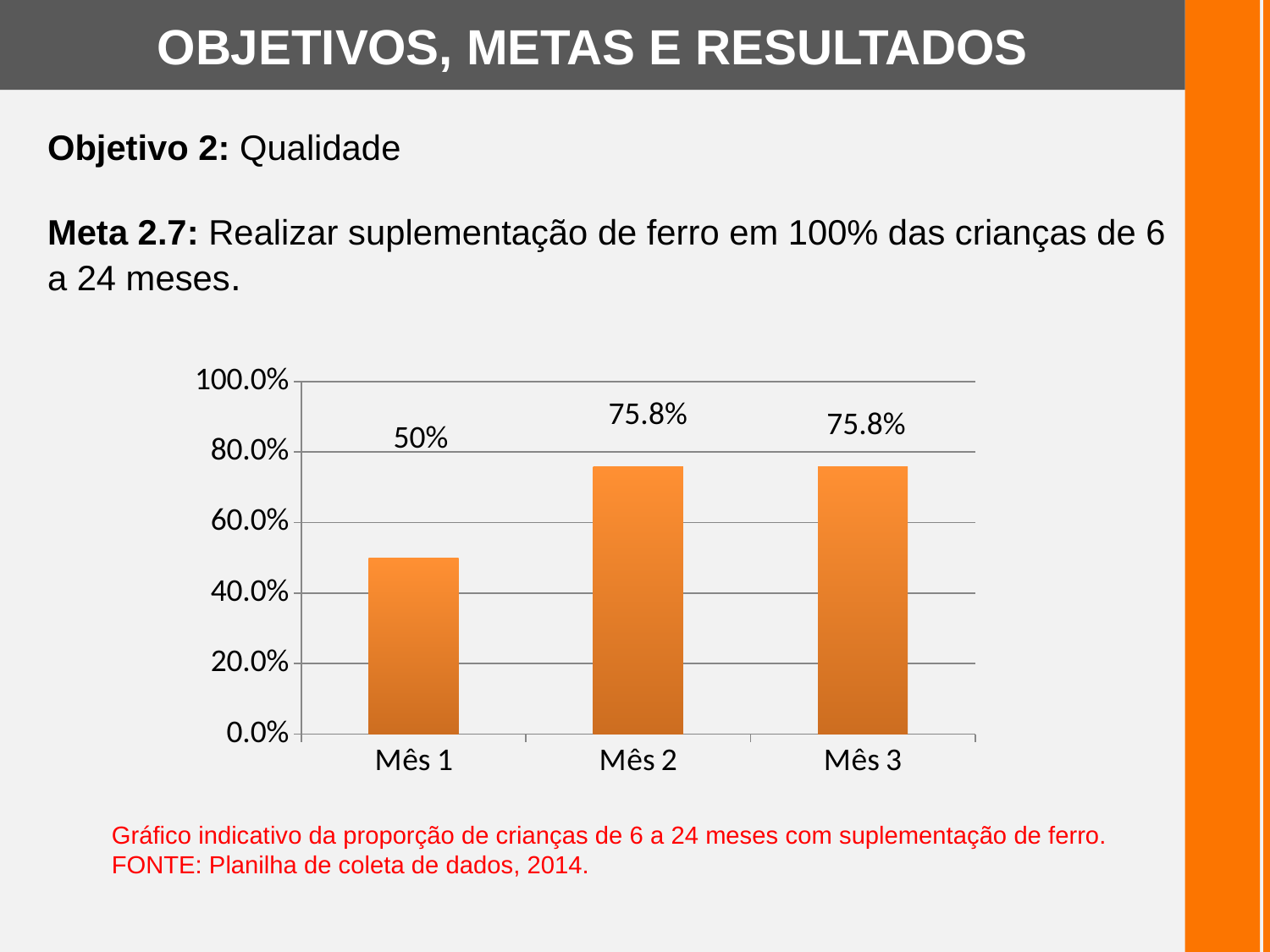
Which month has the lowest value? Mês 1 Which is larger, the value for Mês 1 or the value for Mês 3? Mês 3 Do the values rise or fall from Mês 1 to Mês 2? Rise What is the value for Mês 3? 75.8% What is the value for Mês 1? 50% What is the value for Mês 2? 75.8% What kind of chart is shown on the slide? Bar chart How many categories are shown on the x axis? 3 What is the highest value shown on the y axis? 100.0% Is the value for Mês 1 greater or less than 80.0%? less Is the value for Mês 2 greater or less than 60.0%? greater What is the difference between the values for Mês 2 and Mês 1? 25.8%